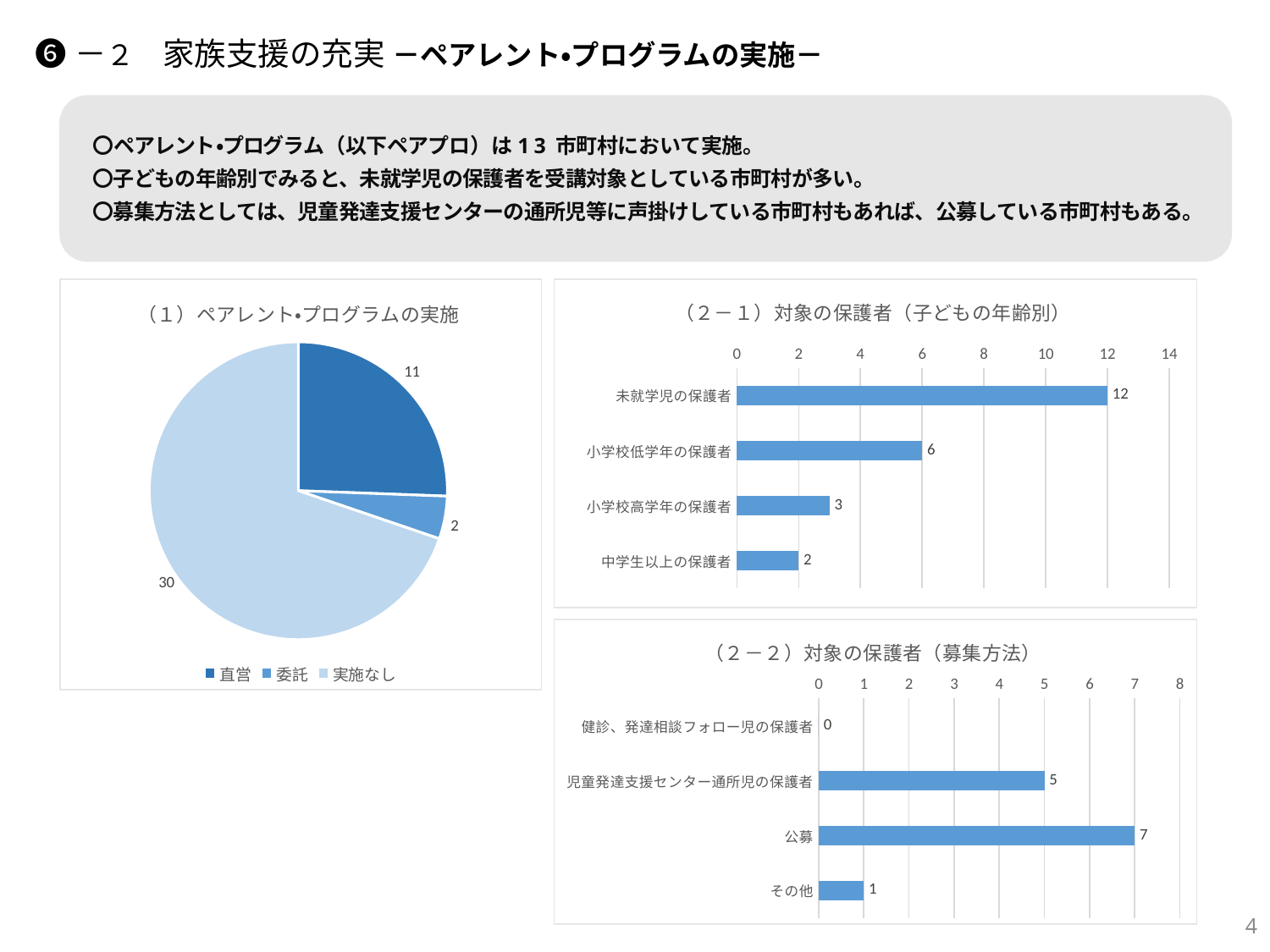
In the chart (2-2) 対象の保護者（募集方法）, what is the value for 公募? 7 In the chart (2-1) 対象の保護者（子どもの年齢別）, which category has the highest value? 未就学児の保護者 In the chart (2-1) 対象の保護者（子どもの年齢別）, what is the difference between 未就学児の保護者 and 小学校高学年の保護者? 9 In the chart (2-1) 対象の保護者（子どもの年齢別）, which category has the lowest value? 中学生以上の保護者 How many categories are shown in the chart (2-2) 対象の保護者（募集方法）? 4 In the pie chart (1) ペアレント・プログラムの実施, how many entries does the legend list? 3 In the chart (2-1) 対象の保護者（子どもの年齢別）, what is the value for 小学校低学年の保護者? 6 In the pie chart (1) ペアレント・プログラムの実施, what is the value for 委託? 2 In the chart (2-2) 対象の保護者（募集方法）, which is larger, 児童発達支援センター通所児の保護者 or その他? 児童発達支援センター通所児の保護者 In the pie chart (1) ペアレント・プログラムの実施, what is the difference between the values for 直営 and 委託? 9 In the pie chart (1) ペアレント・プログラムの実施, what is the value for 実施なし? 30 What kind of chart is (1) ペアレント・プログラムの実施? Pie chart